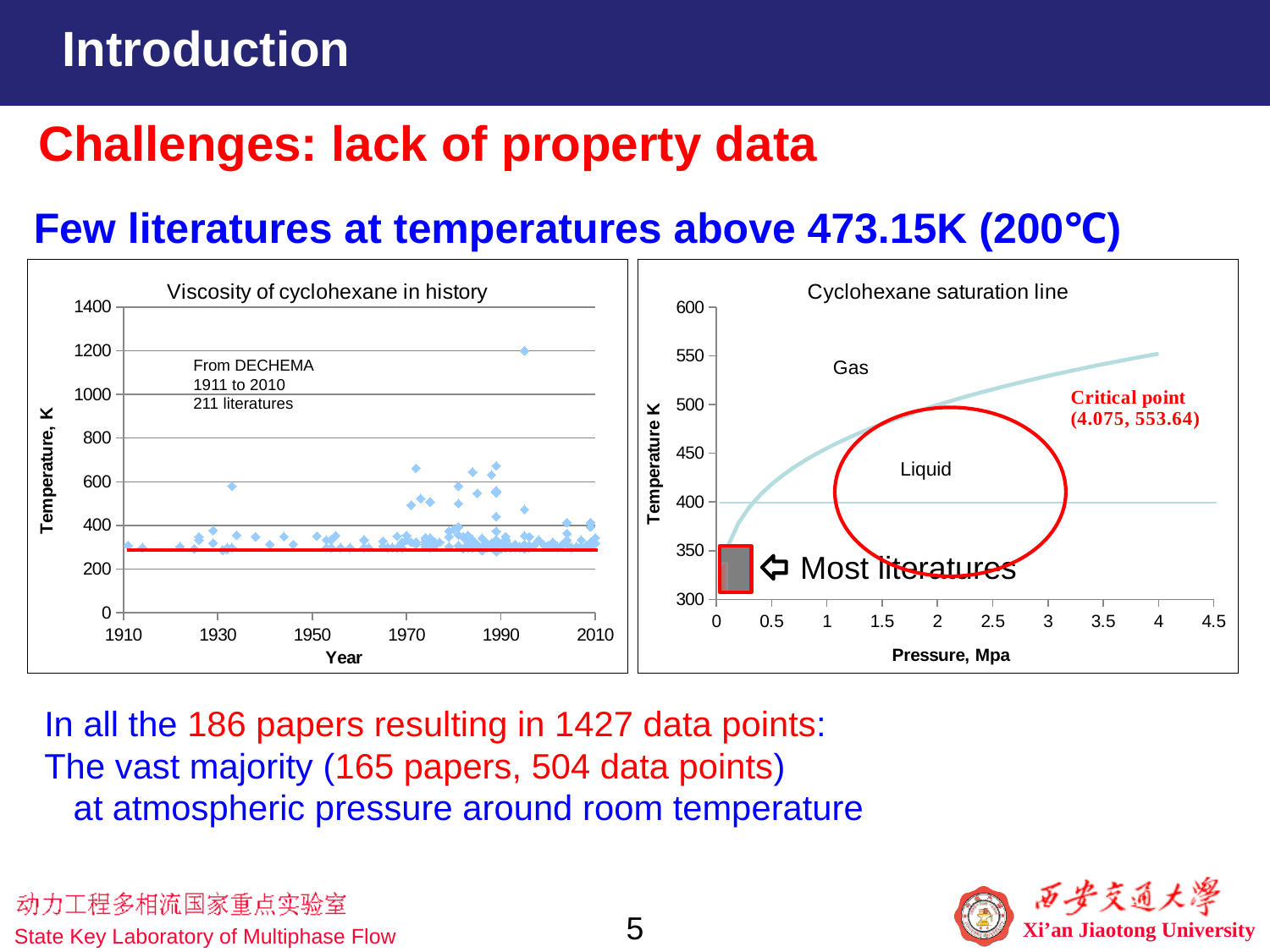
In the right chart 'Cyclohexane saturation line', does the saturation temperature rise or fall as pressure increases? rise In the right chart 'Cyclohexane saturation line', is the saturation temperature at a pressure of 0.5 MPa greater or less than 400? greater What is the title of the chart on the right? Cyclohexane saturation line What kind of chart is the left chart, 'Viscosity of cyclohexane in history'? scatter chart In the left chart 'Viscosity of cyclohexane in history', how many literatures does the annotation say the data comes from? 211 literatures In the left chart 'Viscosity of cyclohexane in history', is the temperature of the highest data point greater or less than 1000? greater In the left chart 'Viscosity of cyclohexane in history', what year range does the annotation give for the DECHEMA data? 1911 to 2010 In the left chart 'Viscosity of cyclohexane in history', what is the label of the x axis? Year What is the title of the chart on the left? Viscosity of cyclohexane in history In the right chart 'Cyclohexane saturation line', what are the coordinates given for the critical point? (4.075, 553.64) In the left chart 'Viscosity of cyclohexane in history', is the temperature of the highest data point greater or less than 1400? less What kind of chart is the right chart, 'Cyclohexane saturation line'? line chart